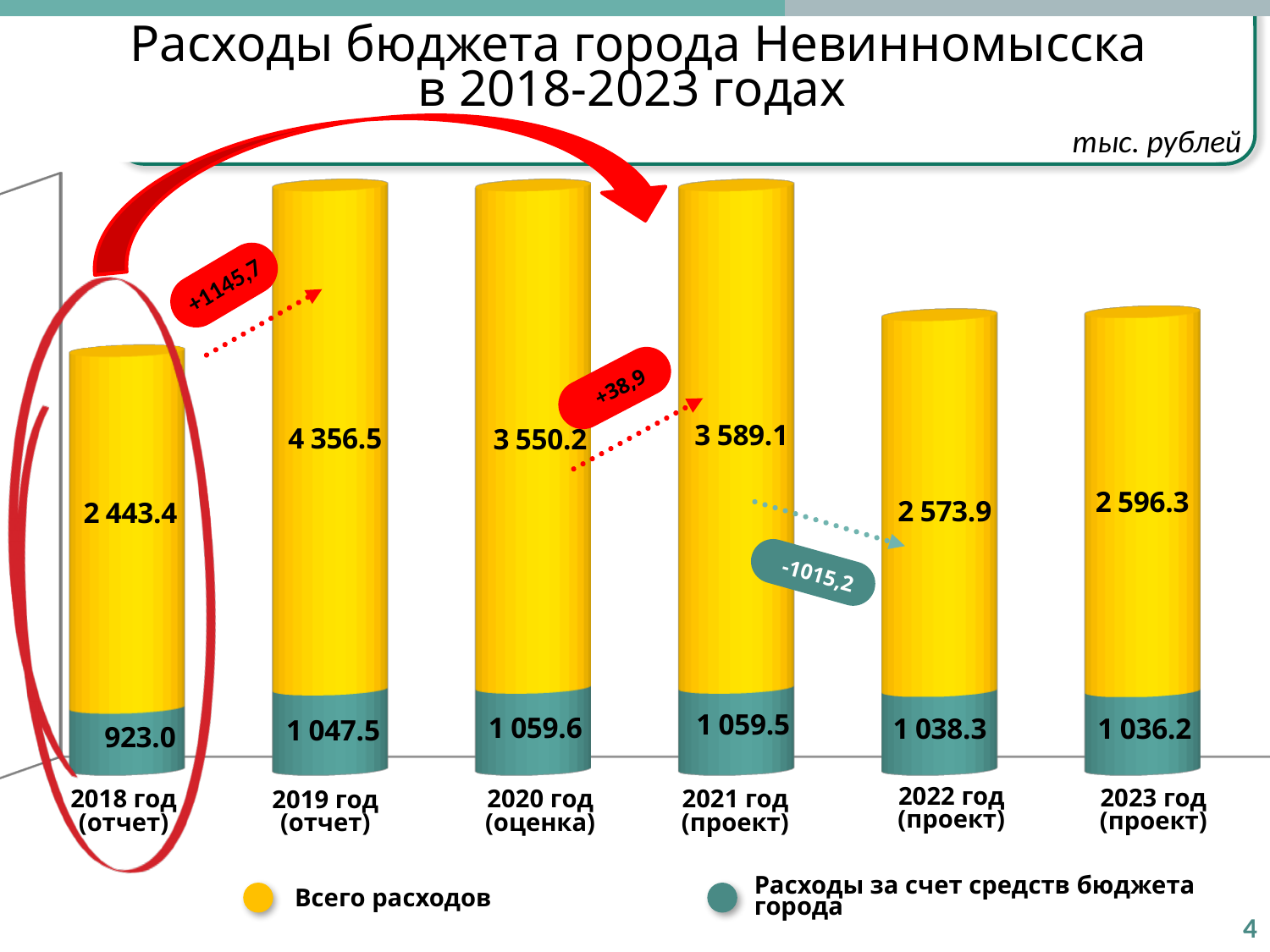
Which year has the lowest value of Всего расходов? 2018 год (отчет) What is the value of Всего расходов for 2019 год (отчет)? 4 356.5 Which year has a larger value of Всего расходов, 2022 год (проект) or 2023 год (проект)? 2023 год (проект) What is the value of Расходы за счет средств бюджета города for 2020 год (оценка)? 1 059.6 What kind of chart is shown on the slide? bar chart How many series does the legend list? 2 What is the difference in Всего расходов between 2021 год (проект) and 2020 год (оценка)? 38.9 Which year has the highest value of Всего расходов? 2019 год (отчет) What is the value of Расходы за счет средств бюджета города for 2018 год (отчет)? 923.0 What is the difference in Расходы за счет средств бюджета города between 2021 год (проект) and 2022 год (проект)? 21.2 Which year has the lowest value of Расходы за счет средств бюджета города? 2018 год (отчет) How many years are shown on the chart? 6